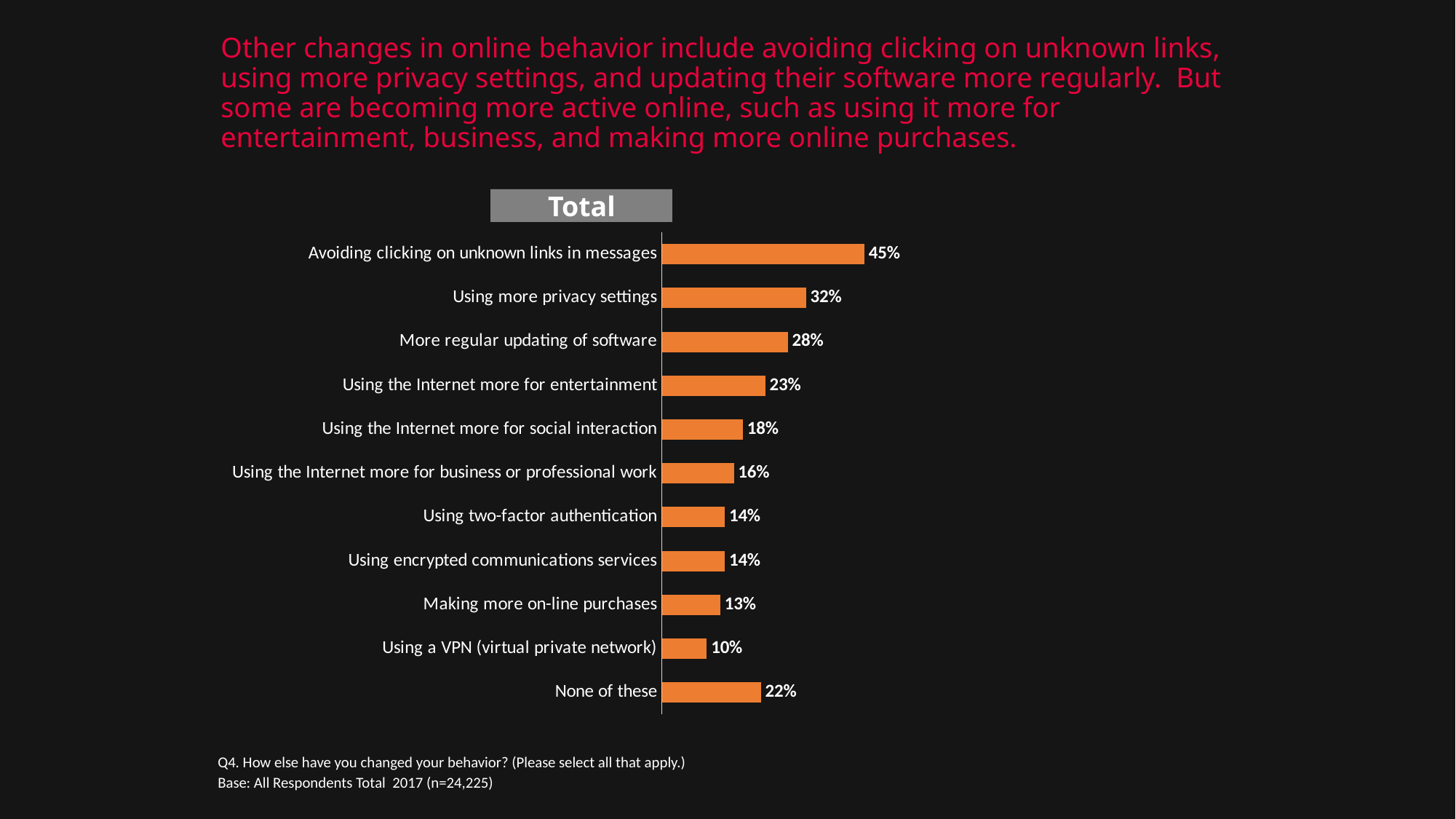
Which category has the lowest value in the chart? Using a VPN (virtual private network) What is the label shown in the grey box above the chart? Total What is the difference between 'Using more privacy settings' and 'More regular updating of software'? 4% What is the difference between the highest value and the 'None of these' value? 23% What percentage selected 'None of these'? 22% What is the value for 'Using a VPN (virtual private network)'? 10% What kind of chart is shown on the slide? Bar chart How many categories are shown in the chart? 11 Which category has the highest value in the chart? Avoiding clicking on unknown links in messages Which is larger: 'Using the Internet more for entertainment' or 'None of these'? Using the Internet more for entertainment What percentage of respondents reported avoiding clicking on unknown links in messages? 45% What is the value for 'Using the Internet more for business or professional work'? 16%